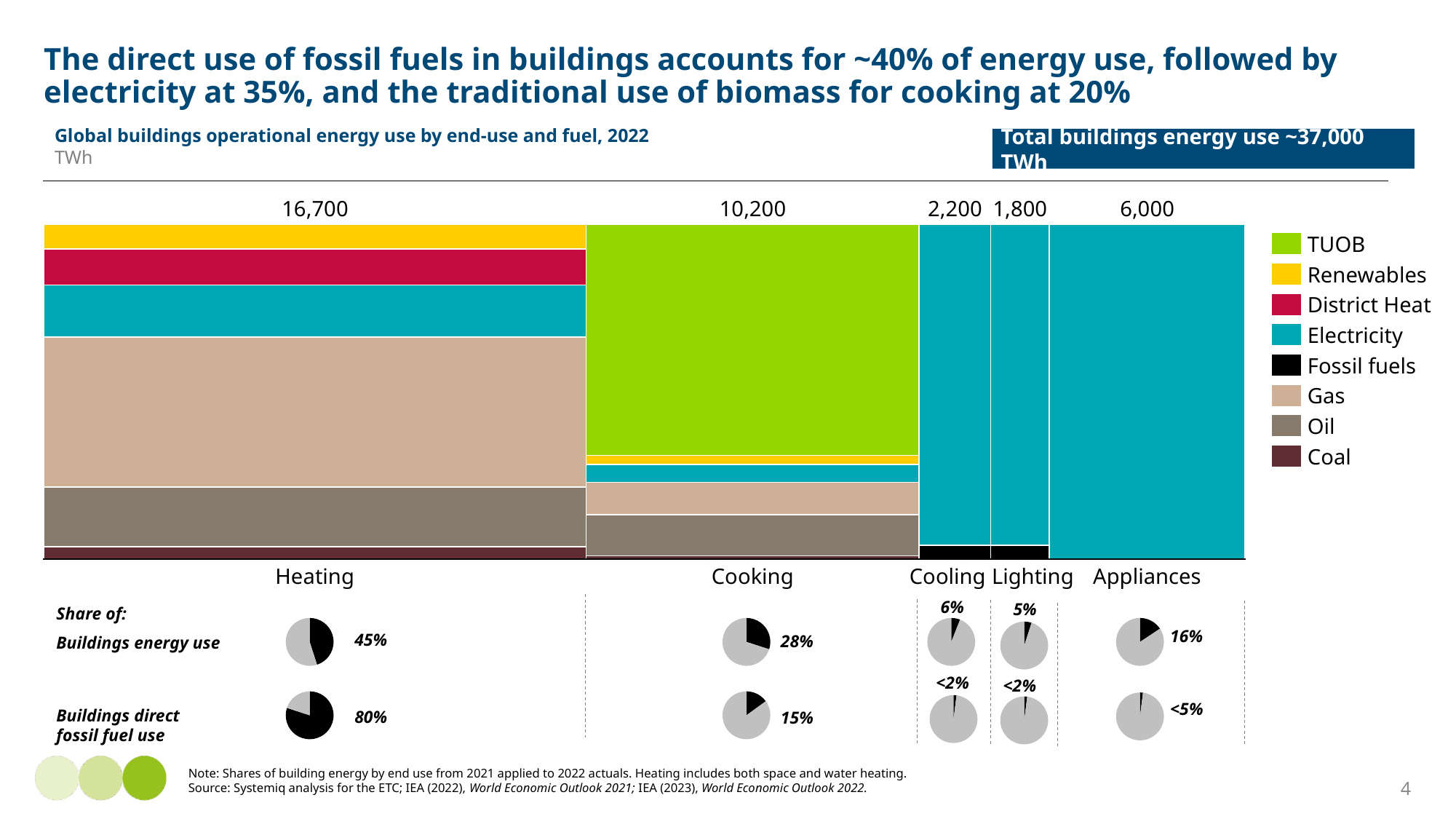
What is the difference in energy use between Cooling and Lighting? 400 What share of buildings direct fossil fuel use does Cooking account for? 15% How many fuel types does the legend list? 8 Which end-use category has the lowest energy use? Lighting What is the difference in energy use between Heating and Cooking? 6,500 What is the energy use value shown for Appliances? 6,000 Which has higher energy use, Appliances or Cooking? Cooking What is the total energy use value shown for Heating? 16,700 Which end-use category has the highest energy use? Heating What is the energy use value shown for Cooking? 10,200 What share of buildings energy use does Heating account for, according to the pie chart? 45% How many end-use categories are shown along the bottom of the chart? 5